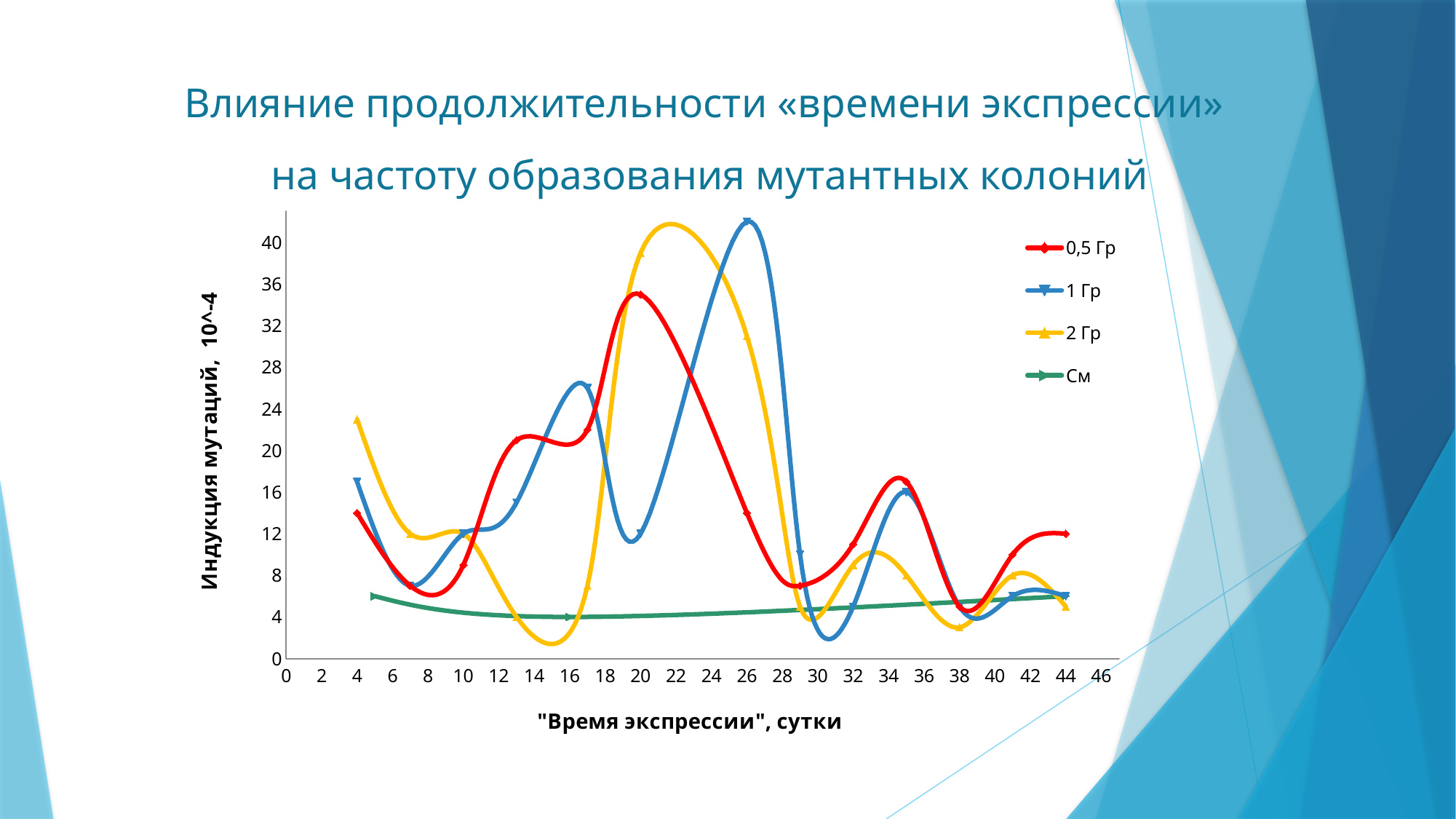
What kind of chart is shown on the slide? line chart What is the label of the horizontal axis? "Время экспрессии", сутки Is the value for 1 Гр at 26 days greater or less than 40? greater Which series stays lowest and nearly flat across the whole x axis? См At 20 days, which series has the higher value: 0,5 Гр or 1 Гр? 0,5 Гр At 4 days, which series has the higher value: 2 Гр or 0,5 Гр? 2 Гр How many series does the legend list? 4 Is the value for См at 4 days greater or less than 8? less What are the series names listed in the legend? 0,5 Гр, 1 Гр, 2 Гр, См Is the value for 0,5 Гр at 20 days greater or less than 32? greater